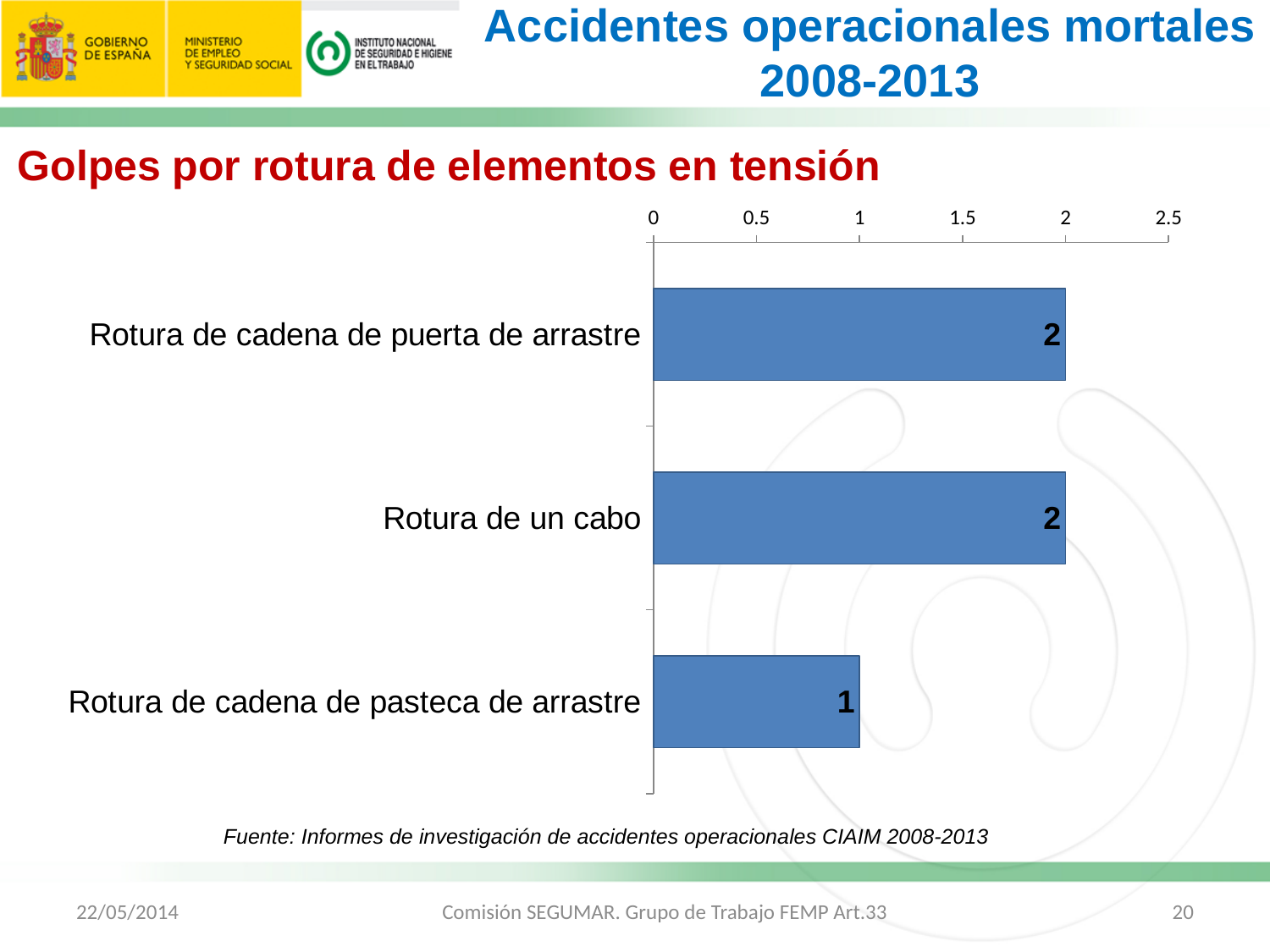
What is the heading above the chart? Golpes por rotura de elementos en tensión What is the value for Rotura de un cabo? 2 How many categories are shown in the chart? 3 What kind of chart is shown on the slide? bar chart What is the value for Rotura de cadena de pasteca de arrastre? 1 What is the value for Rotura de cadena de puerta de arrastre? 2 What is the difference between the values for Rotura de un cabo and Rotura de cadena de pasteca de arrastre? 1 What is the total of the values for all three categories? 5 Which category has the lowest value? Rotura de cadena de pasteca de arrastre Is the value for Rotura de cadena de pasteca de arrastre greater or less than 1.5? less Is the value for Rotura de un cabo greater or less than 1.5? greater Which is larger, the value for Rotura de cadena de puerta de arrastre or the value for Rotura de cadena de pasteca de arrastre? Rotura de cadena de puerta de arrastre